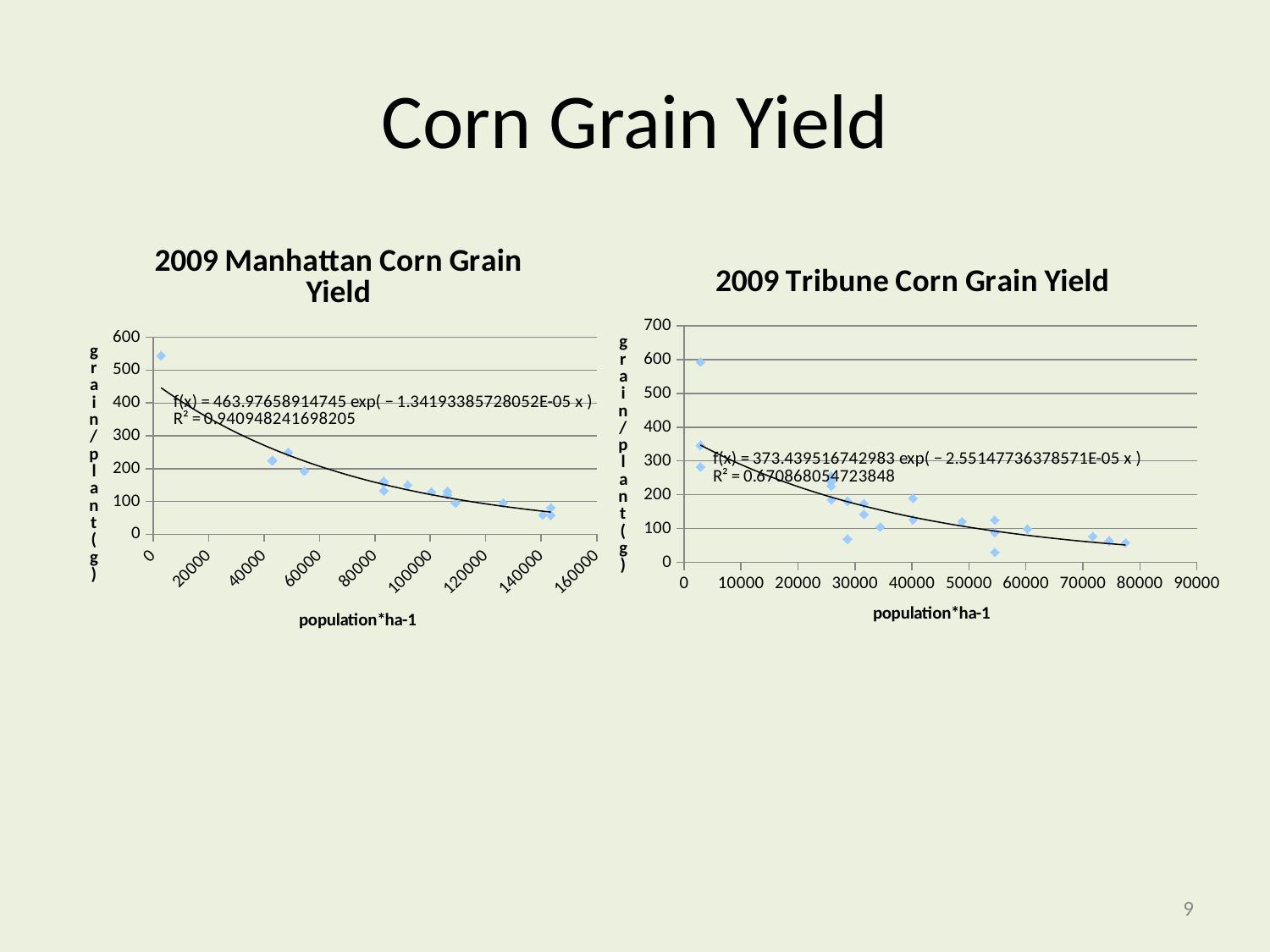
What R² value is printed on the 2009 Tribune Corn Grain Yield chart? 0.670868054723848 What is the highest value shown on the y-axis of the 2009 Tribune Corn Grain Yield chart? 700 In the 2009 Tribune Corn Grain Yield chart, is the highest point (near population 3000) greater or less than 500? greater What R² value is printed on the 2009 Manhattan Corn Grain Yield chart? 0.940948241698205 What is the x-axis label on the 2009 Tribune Corn Grain Yield chart? population*ha-1 In the 2009 Manhattan Corn Grain Yield chart, do the grain per plant values rise or fall as population increases? fall In the 2009 Tribune Corn Grain Yield chart, do the grain per plant values rise or fall as population increases? fall Which chart shows the higher R² value, 2009 Manhattan Corn Grain Yield or 2009 Tribune Corn Grain Yield? 2009 Manhattan Corn Grain Yield In the 2009 Manhattan Corn Grain Yield chart, is the value of the point at the lowest population (near 5000) greater or less than 500? greater In the 2009 Tribune Corn Grain Yield chart, is the lowest point (near population 55000) greater or less than 100? less What kind of chart is the 2009 Manhattan Corn Grain Yield chart? scatter chart